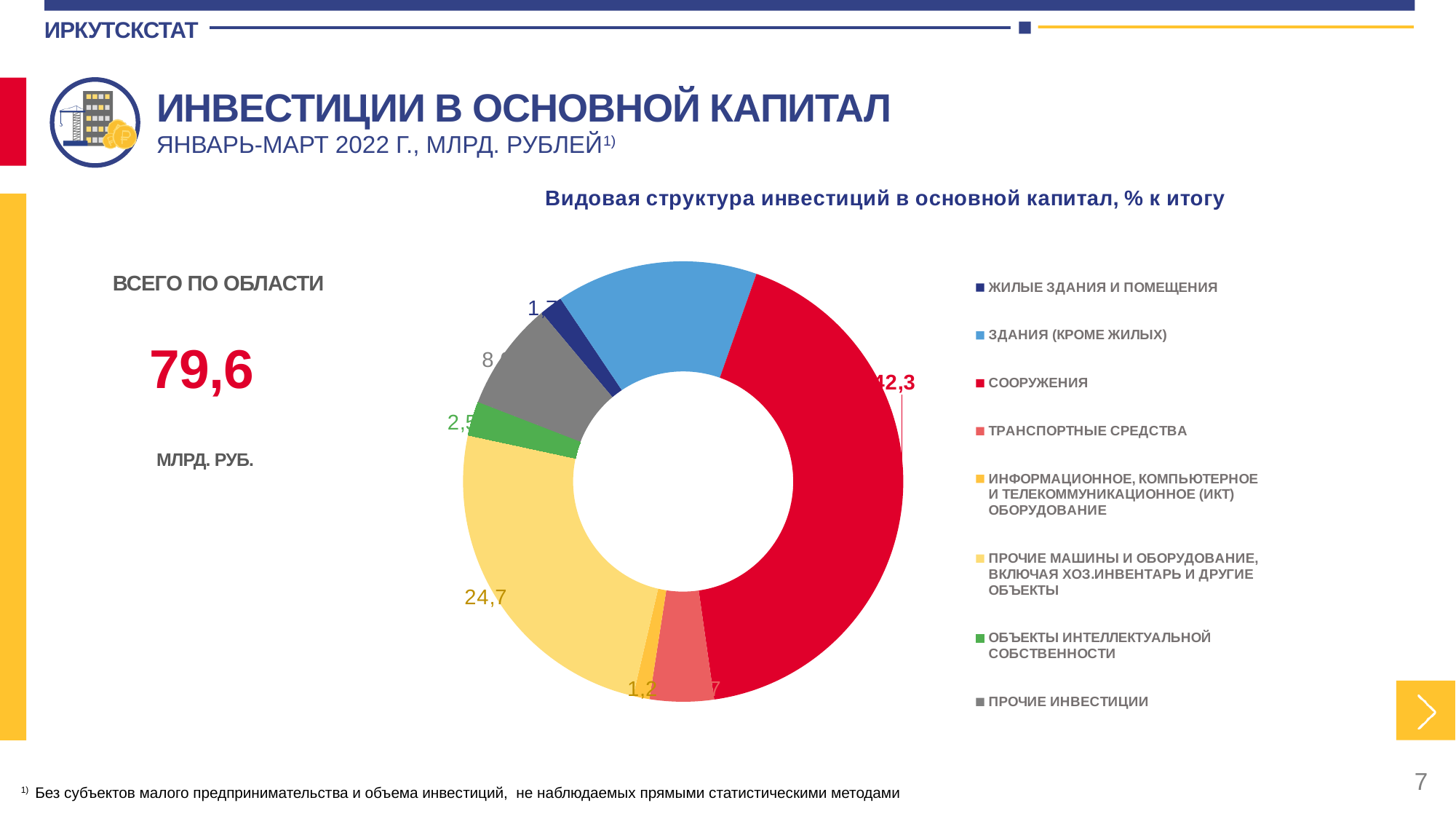
Which is larger: СООРУЖЕНИЯ or ПРОЧИЕ МАШИНЫ И ОБОРУДОВАНИЕ? СООРУЖЕНИЯ Which is larger: ОБЪЕКТЫ ИНТЕЛЛЕКТУАЛЬНОЙ СОБСТВЕННОСТИ or ИКТ ОБОРУДОВАНИЕ? ОБЪЕКТЫ ИНТЕЛЛЕКТУАЛЬНОЙ СОБСТВЕННОСТИ What is the value for СООРУЖЕНИЯ in the chart? 42,3 Which category has the largest share in the chart? СООРУЖЕНИЯ What is the difference between the values for СООРУЖЕНИЯ and ПРОЧИЕ МАШИНЫ И ОБОРУДОВАНИЕ? 17,6 What kind of chart is shown on the slide? Doughnut (pie) chart What colour represents СООРУЖЕНИЯ in the chart? Red What is the title of the chart? Видовая структура инвестиций в основной капитал, % к итогу What is the value for ОБЪЕКТЫ ИНТЕЛЛЕКТУАЛЬНОЙ СОБСТВЕННОСТИ? 2,5 What is the value for ИНФОРМАЦИОННОЕ, КОМПЬЮТЕРНОЕ И ТЕЛЕКОММУНИКАЦИОННОЕ (ИКТ) ОБОРУДОВАНИЕ? 1,2 What is the value for ПРОЧИЕ МАШИНЫ И ОБОРУДОВАНИЕ, ВКЛЮЧАЯ ХОЗ.ИНВЕНТАРЬ И ДРУГИЕ ОБЪЕКТЫ? 24,7 How many categories does the chart legend list? 8